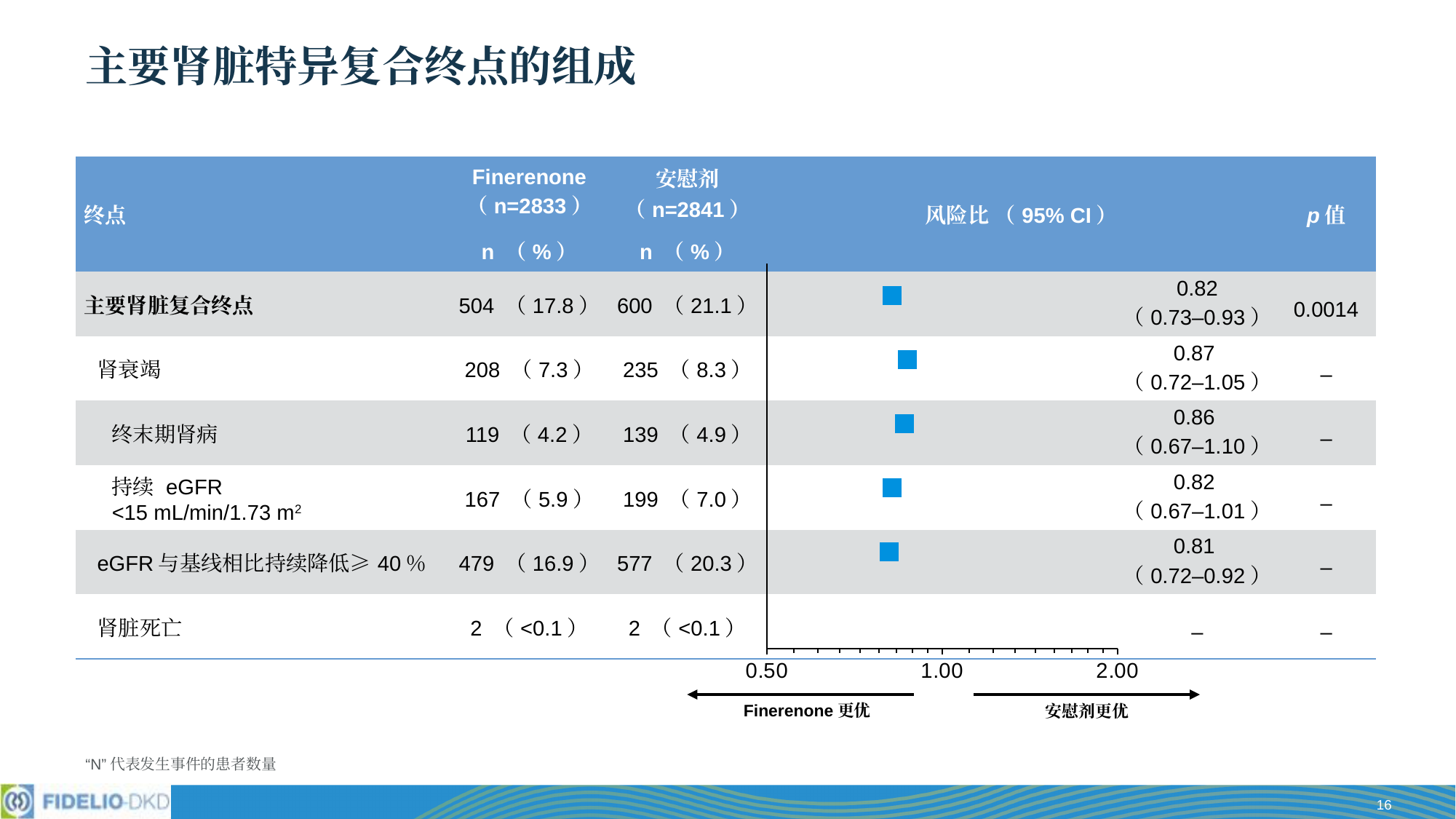
How many endpoints have a hazard ratio point plotted in the forest plot? 5 What are the tick labels shown on the x axis of the forest plot? 0.50, 1.00, 2.00 Is the hazard ratio for 主要肾脏复合终点 greater or less than 1.00? less Which endpoint has the highest hazard ratio in the forest plot? 肾衰竭 What is the hazard ratio (风险比) for 肾衰竭? 0.87 What is the p value for 主要肾脏复合终点? 0.0014 What does the label under the left-pointing arrow below the x axis say? Finerenone 更优 Which has the larger hazard ratio, 终末期肾病 or 持续 eGFR <15 mL/min/1.73 m2? 终末期肾病 What is the difference between the hazard ratio for 肾衰竭 and the hazard ratio for eGFR 与基线相比持续降低≥ 40 %? 0.06 What is the 95% CI for the hazard ratio of 主要肾脏复合终点? 0.73–0.93 What kind of chart is shown next to the table? forest plot Which endpoint has the lowest hazard ratio in the forest plot? eGFR 与基线相比持续降低≥ 40 %